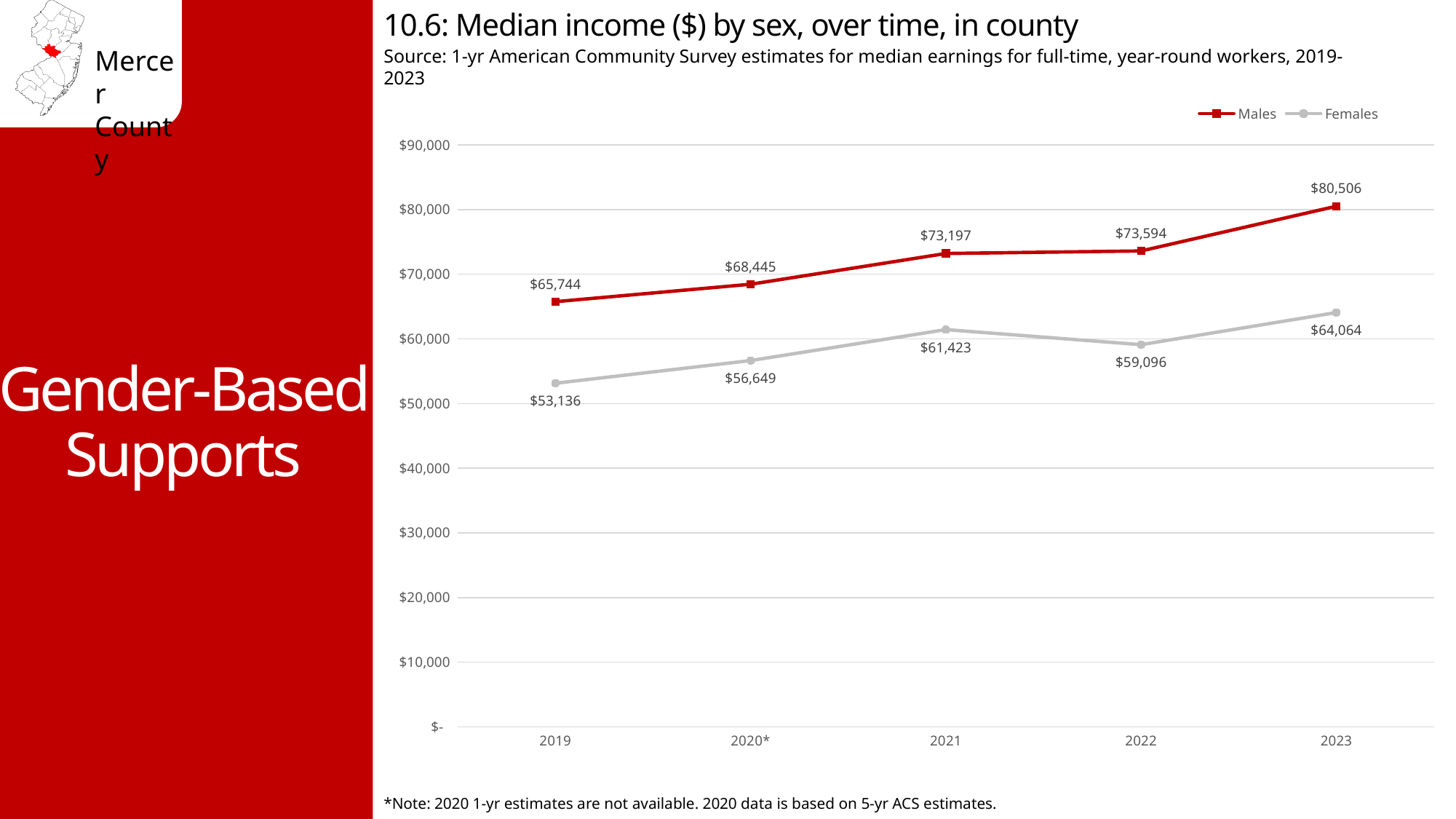
What was the median income for females in 2022? $59,096 What kind of chart is shown on the slide? line chart How many years are shown on the x axis? 5 Which is larger: female median income in 2021 or in 2022? 2021 How many series does the legend list? 2 In which year was the median income for males highest? 2023 What is the difference between male median income in 2021 and 2019? $7,453 What is the difference between male and female median income in 2023? $16,442 In which year was the median income for females lowest? 2019 What was the median income for females in 2019? $53,136 What was the median income for males in 2023? $80,506 Is the male median income in 2020* greater or less than $70,000? less